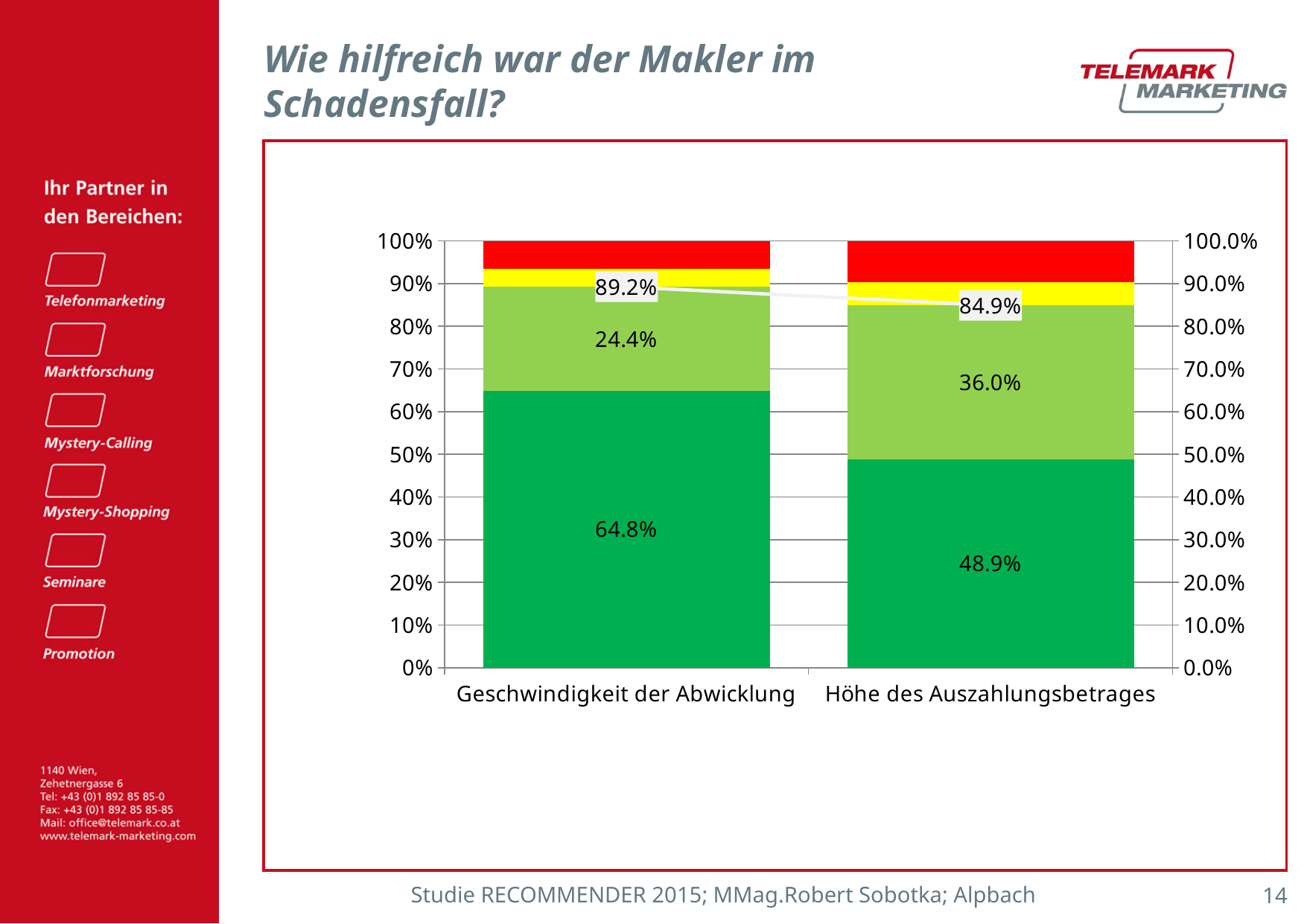
What is the difference between the dark green segment values for Geschwindigkeit der Abwicklung and Höhe des Auszahlungsbetrages? 15.9 percentage points What is the value of the light green segment for Höhe des Auszahlungsbetrages? 36.0% Which category has the larger dark green segment, Geschwindigkeit der Abwicklung or Höhe des Auszahlungsbetrages? Geschwindigkeit der Abwicklung What value does the line series show for Geschwindigkeit der Abwicklung? 89.2% What is the value of the bottom (dark green) segment for Höhe des Auszahlungsbetrages? 48.9% What is the difference between the line values for Geschwindigkeit der Abwicklung and Höhe des Auszahlungsbetrages? 4.3 percentage points What value does the line series show for Höhe des Auszahlungsbetrages? 84.9% What is the value of the light green segment for Geschwindigkeit der Abwicklung? 24.4% Does the line series rise or fall from Geschwindigkeit der Abwicklung to Höhe des Auszahlungsbetrages? Fall How many categories are shown on the x axis? 2 What is the value of the bottom (dark green) segment for Geschwindigkeit der Abwicklung? 64.8% What kind of chart is shown on the slide? Stacked bar chart with a line